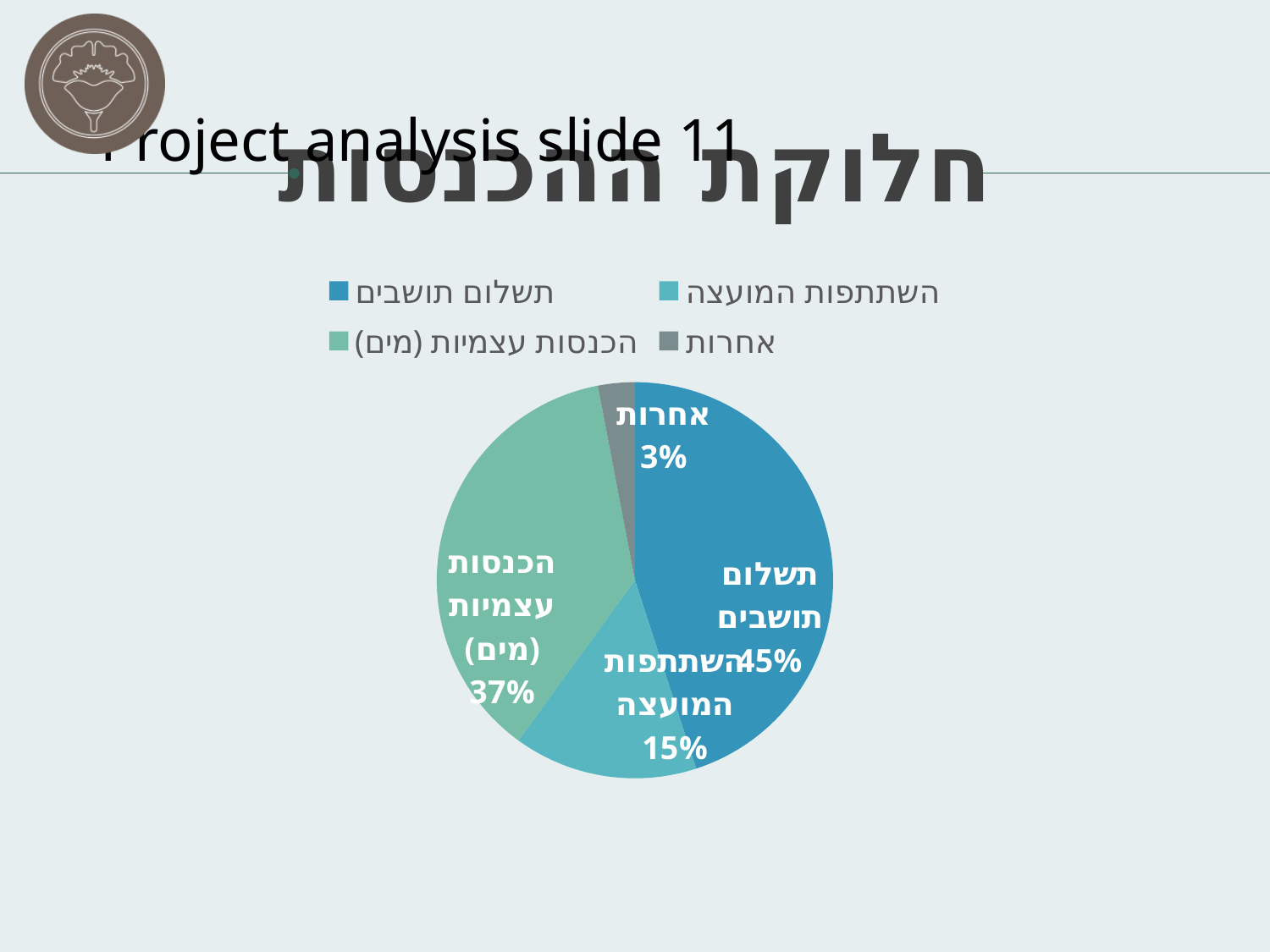
What is the title of the chart? חלוקת ההכנסות What is the difference in percentage points between תשלום תושבים and הכנסות עצמיות (מים)? 8 What share of the pie does הכנסות עצמיות (מים) represent? 37% What share of the pie does אחרות represent? 3% Which category has the largest slice of the pie? תשלום תושבים How many slices does the pie chart have? 4 Which category has the smallest slice of the pie? אחרות What kind of chart is shown on the slide? Pie chart What share of the pie does השתתפות המועצה represent? 15% What share of the pie does תשלום תושבים represent? 45% What is the difference in percentage points between השתתפות המועצה and אחרות? 12 Which is larger, the slice for השתתפות המועצה or the slice for הכנסות עצמיות (מים)? הכנסות עצמיות (מים)